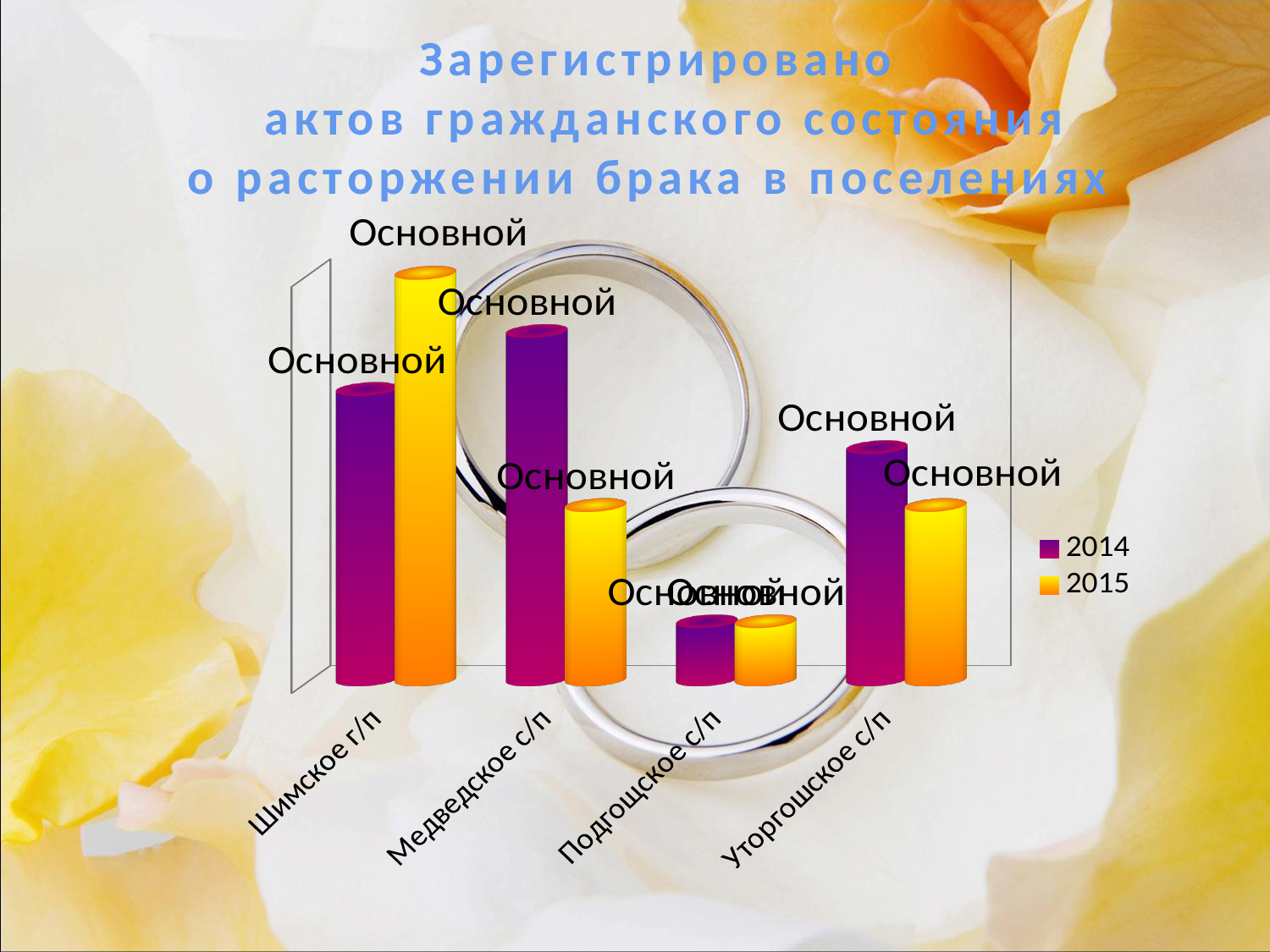
What years are listed in the chart's legend? 2014 and 2015 Which colour represents the 2015 series in the chart? yellow Which settlement has the highest value for 2014? Медведское с/п Which settlement has the lowest value for 2014? Подгощское с/п For Уторгошское с/п, which year has the larger value, 2014 or 2015? 2014 How many series does the chart's legend list? 2 Which settlement has the highest value for 2015? Шимское г/п Which settlement has the lowest value for 2015? Подгощское с/п For Медведское с/п, which year has the larger value, 2014 or 2015? 2014 How many categories (settlements) are shown on the x axis of the chart? 4 What kind of chart is shown on the slide? bar chart For Шимское г/п, which year has the larger value, 2014 or 2015? 2015